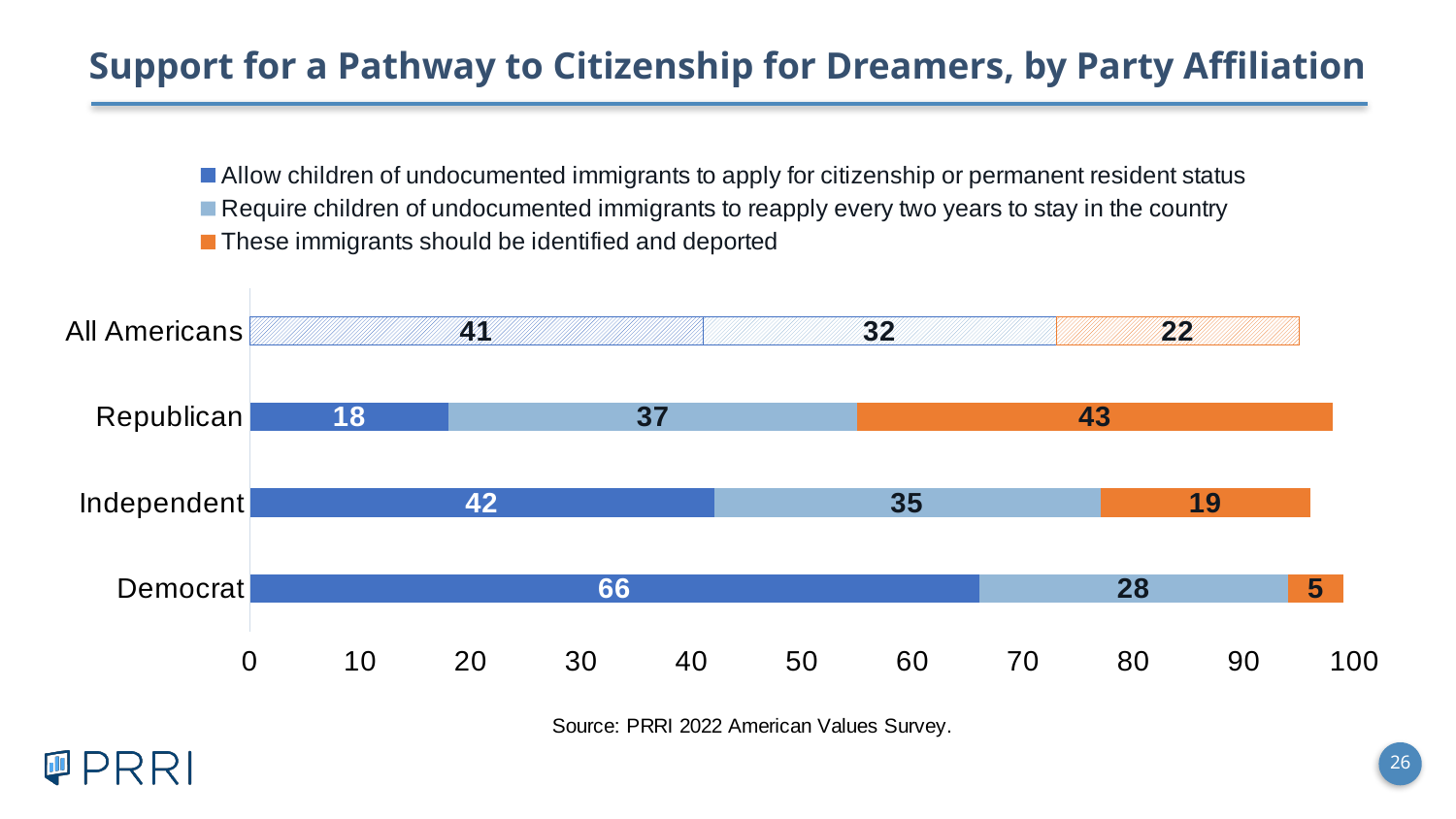
Which is larger: the Independent value for 'identified and deported' or the All Americans value for 'identified and deported'? All Americans How many series does the legend list? 3 What percentage of Democrats say children of undocumented immigrants should be allowed to apply for citizenship or permanent resident status? 66 What is the value for Republicans in the 'These immigrants should be identified and deported' series? 43 How many groups (categories) are shown on the chart? 4 What is the total of the stacked bar for Republican? 98 What is the source cited below the chart? PRRI 2022 American Values Survey What is the value for All Americans in the 'Require children of undocumented immigrants to reapply every two years to stay in the country' series? 32 Which group has the highest value for allowing children of undocumented immigrants to apply for citizenship or permanent resident status? Democrat What is the difference between the Democrat and Republican values for allowing children of undocumented immigrants to apply for citizenship? 48 What kind of chart is shown on the slide? Stacked bar chart Which group has the lowest value for 'These immigrants should be identified and deported'? Democrat